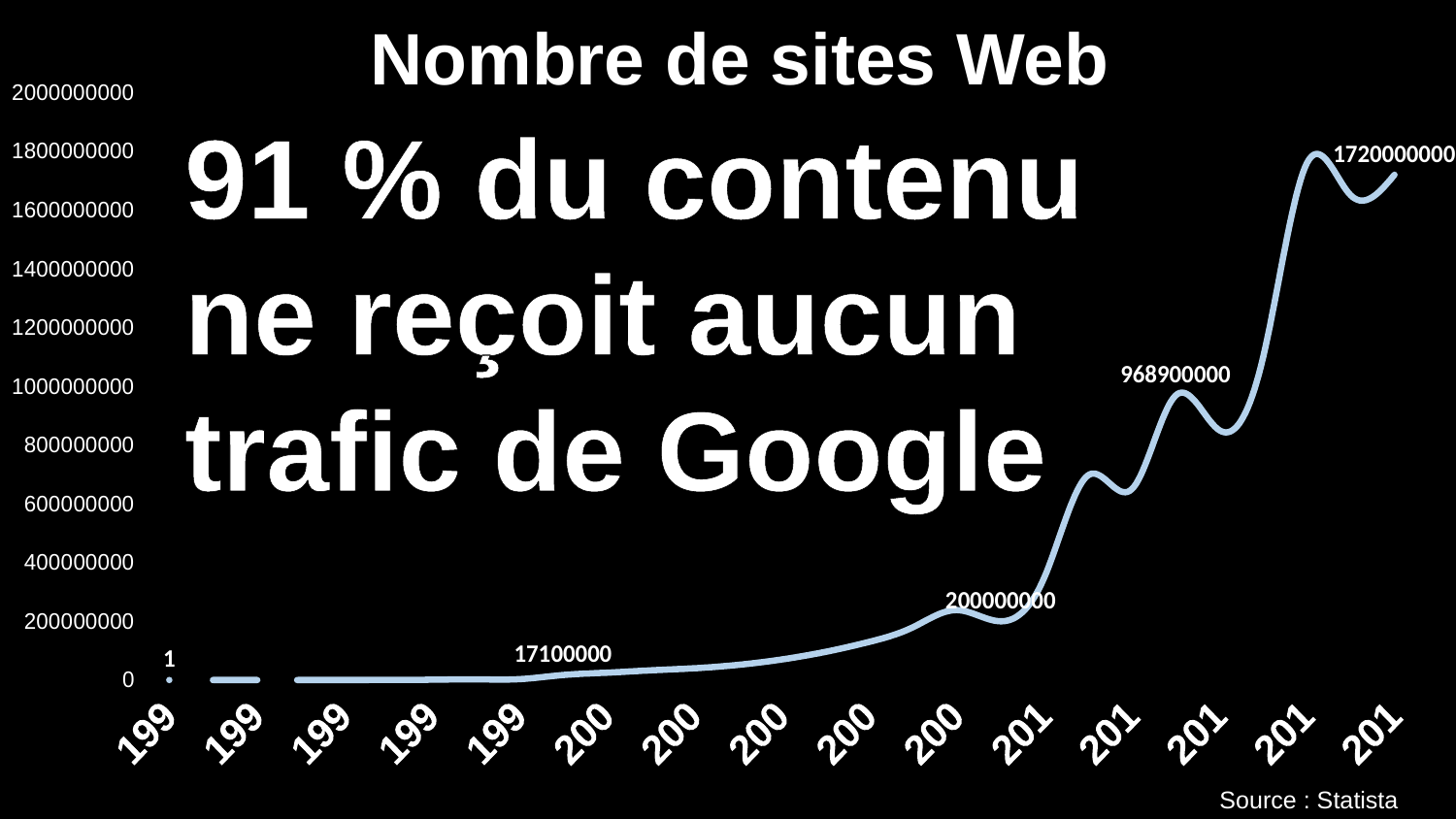
What is the difference between the data labels 1720000000 and 968900000? 751100000 What source is cited for the chart? Statista What is the title of the chart? Nombre de sites Web How many category labels are shown along the x axis? 15 What is the highest value printed as a data label on the chart? 1720000000 What is the lowest value printed as a data label on the chart? 1 Is the value of the last point on the line greater or less than 1600000000? greater What is the difference between the data labels 200000000 and 17100000? 182900000 What type of chart is shown on the slide? line chart Which is larger, the data label 968900000 or the data label 200000000? 968900000 What is the difference between the data labels 968900000 and 200000000? 768900000 Does the number of websites generally rise or fall from left to right along the x axis? rise